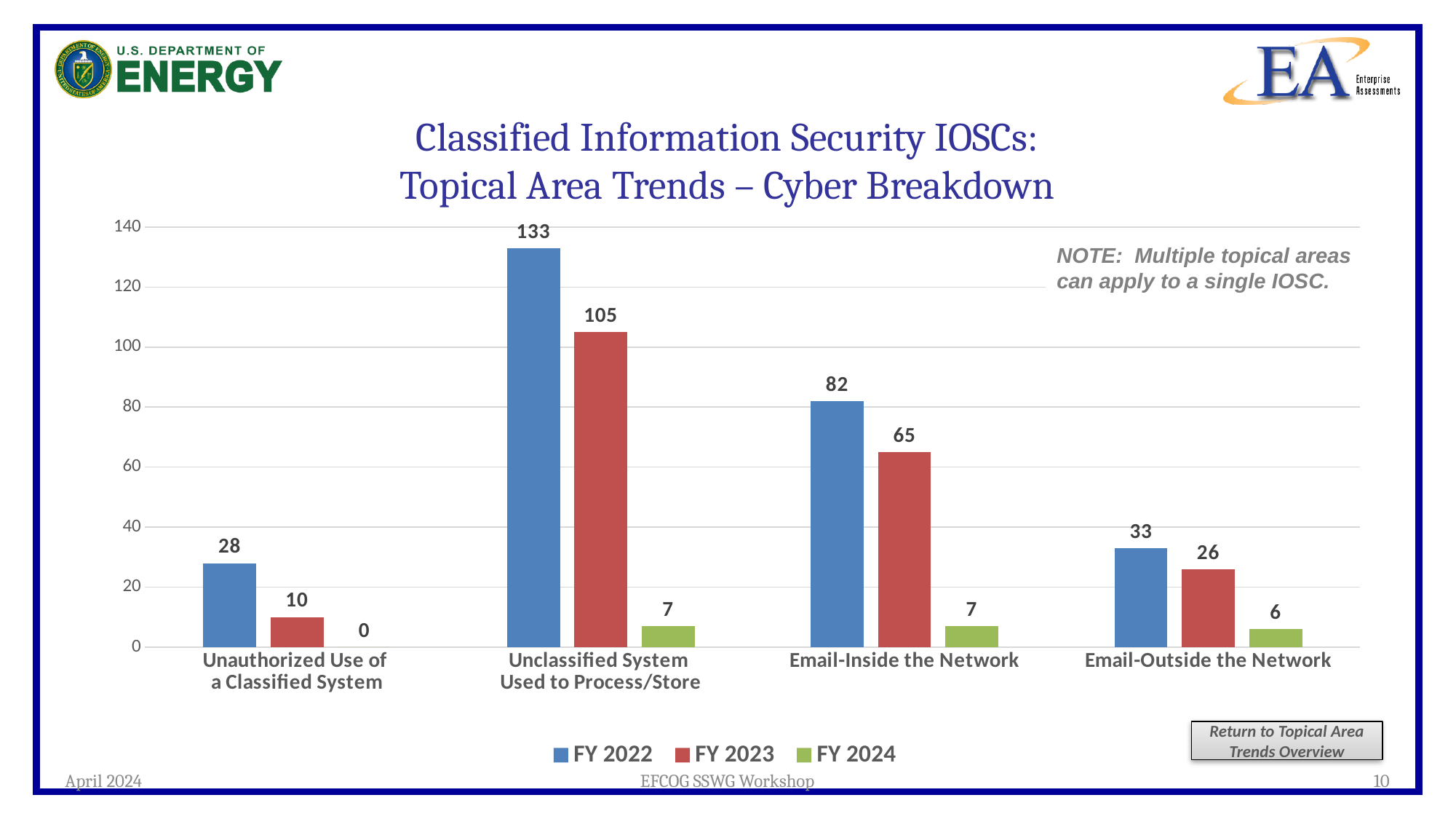
What is the FY 2022 value for Unclassified System Used to Process/Store? 133 What is the difference between the FY 2022 and FY 2023 values for Unclassified System Used to Process/Store? 28 Which series is shown in green in the legend? FY 2024 How many series does the legend list? 3 What kind of chart is shown on the slide? Bar chart Which category has the lowest FY 2023 value? Unauthorized Use of a Classified System How many categories are shown on the x axis? 4 Which is larger: the FY 2022 value for Email-Inside the Network or the FY 2022 value for Email-Outside the Network? Email-Inside the Network What is the FY 2024 value for Email-Outside the Network? 6 Which category has the highest FY 2022 value? Unclassified System Used to Process/Store What is the FY 2024 value for Unauthorized Use of a Classified System? 0 What is the FY 2023 value for Email-Inside the Network? 65